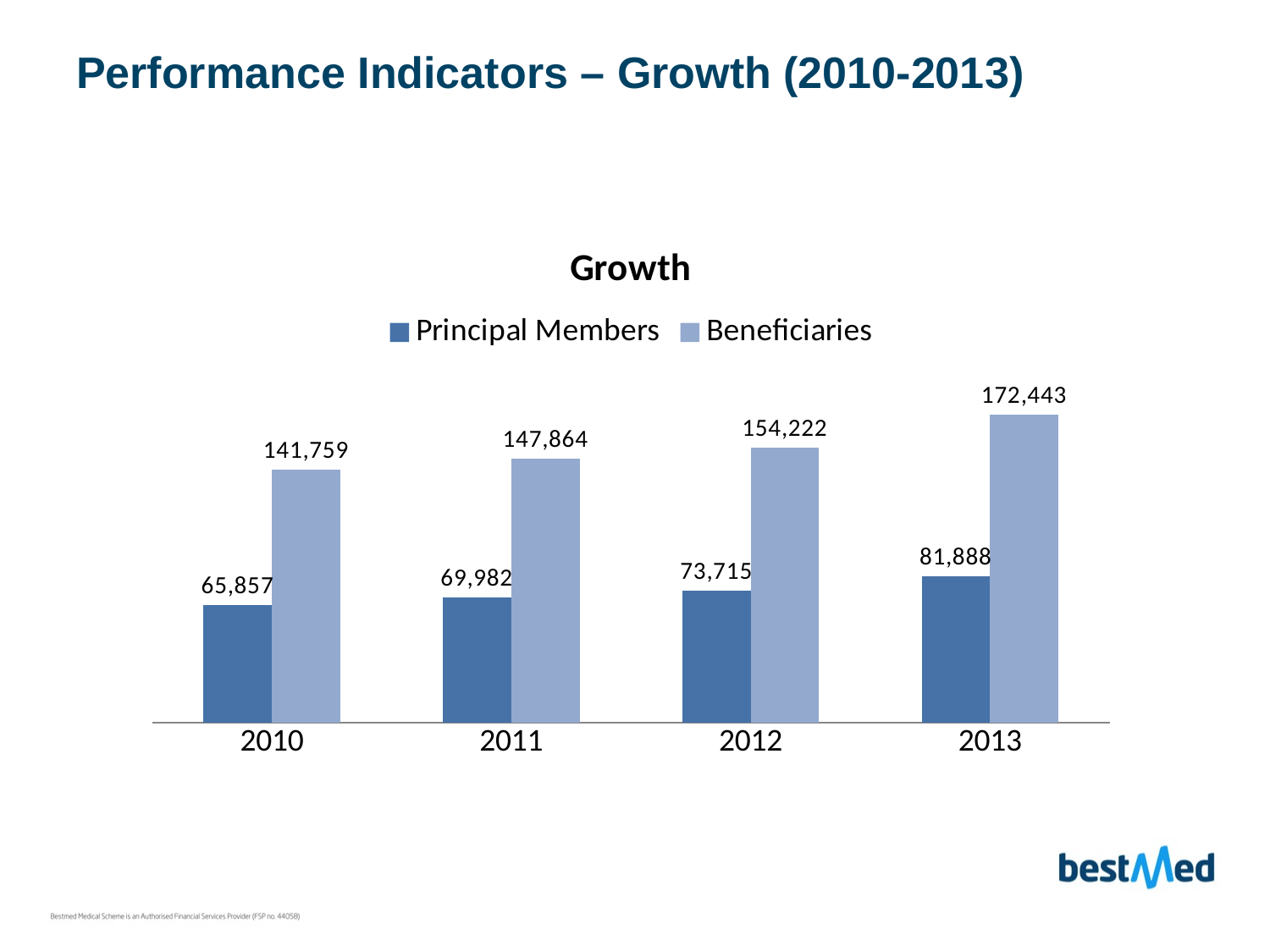
What is the value for Principal Members in 2012? 73,715 What is the value for Principal Members in 2010? 65,857 Which year has the lowest value for Principal Members? 2010 What is the value for Beneficiaries in 2013? 172,443 Which is larger: Principal Members in 2013 or Beneficiaries in 2010? Beneficiaries in 2010 What kind of chart is this? Bar chart What is the difference between Principal Members in 2011 and Principal Members in 2010? 4,125 How many series does the legend list? 2 What is the value for Beneficiaries in 2011? 147,864 Which year has the highest value for Beneficiaries? 2013 What is the difference between Beneficiaries in 2013 and Beneficiaries in 2012? 18,221 How many years are shown on the x axis? 4